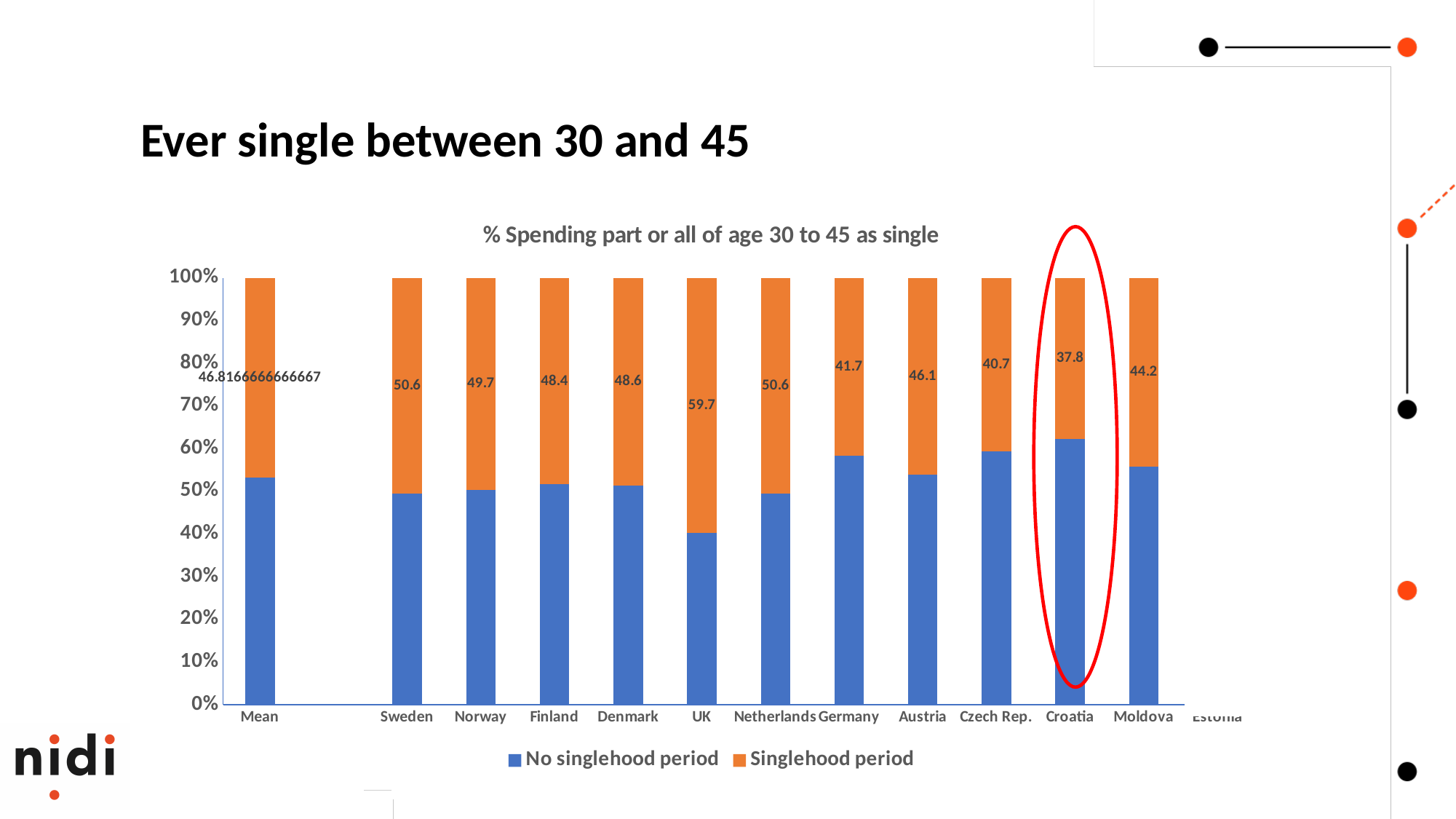
Which country has the lowest Singlehood period value? Croatia What is the Singlehood period value for the UK? 59.7 Is the No singlehood period share for the UK greater or less than 50%? less Is the No singlehood period share for Croatia greater or less than 60%? greater How many series does the legend list? 2 What is the Singlehood period value for Germany? 41.7 Which country has the highest Singlehood period value? UK What kind of chart is shown on the slide? Stacked bar chart Which country's bar is circled in red? Croatia What is the Singlehood period value for Croatia? 37.8 What is the difference between the Singlehood period values for the UK and Croatia? 21.9 Which has a larger Singlehood period value, Germany or Austria? Austria